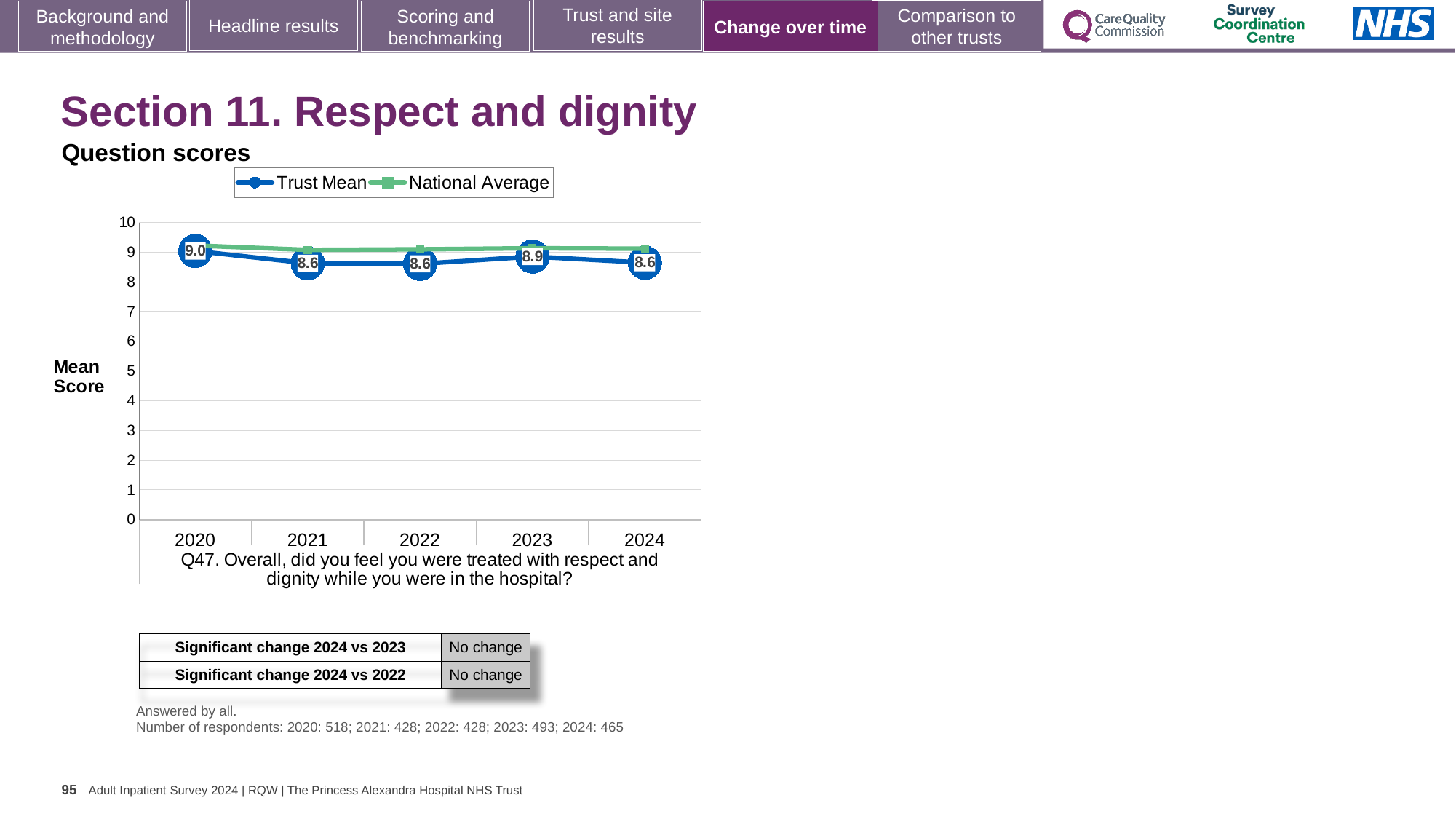
What is the label on the y axis of the chart? Mean Score How many years are plotted on the x axis? 5 Which is larger, the Trust Mean for 2023 or for 2022? 2023 What is the Trust Mean score for 2023? 8.9 In which year is the Trust Mean highest? 2020 What kind of chart is shown? Line chart What is the Trust Mean score for 2020? 9.0 How many series does the legend list? 2 Is the National Average value for 2024 greater or less than 8? greater What is the difference between the Trust Mean in 2020 and in 2021? 0.4 Does the Trust Mean rise or fall from 2020 to 2021? Fall What is the Trust Mean score for 2024? 8.6